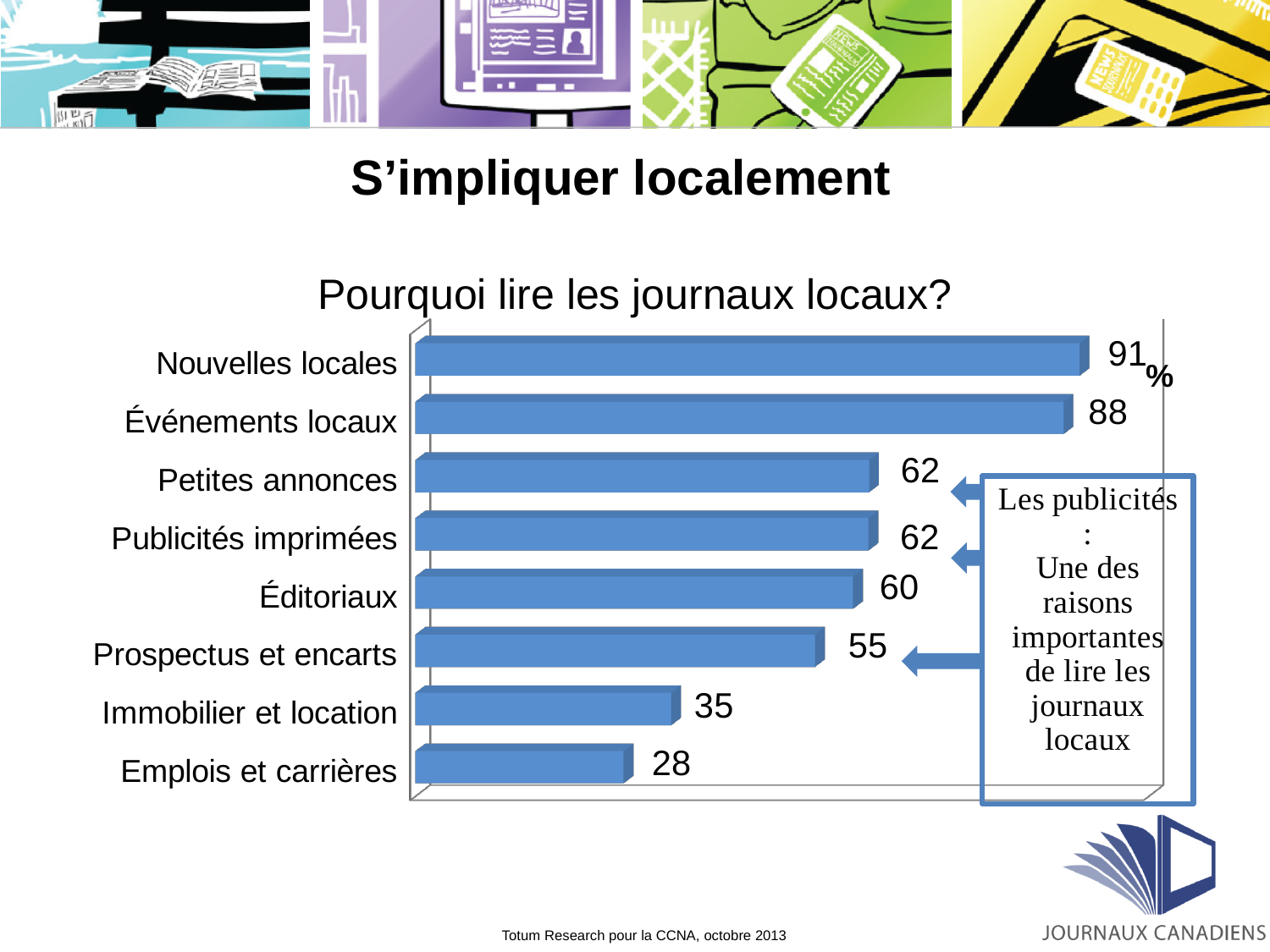
Which category has the highest value? Nouvelles locales Which is larger, the value for Éditoriaux or the value for Prospectus et encarts? Éditoriaux How many categories are shown in the chart? 8 What is the title of the chart? Pourquoi lire les journaux locaux? Which category has the lowest value? Emplois et carrières What is the value for Prospectus et encarts? 55 What is the value for Éditoriaux? 60 What kind of chart is shown on the slide? Bar chart What is the value for Emplois et carrières? 28 What is the difference between the values for Immobilier et location and Emplois et carrières? 7 What is the difference between the values for Nouvelles locales and Événements locaux? 3 What is the value for Nouvelles locales? 91